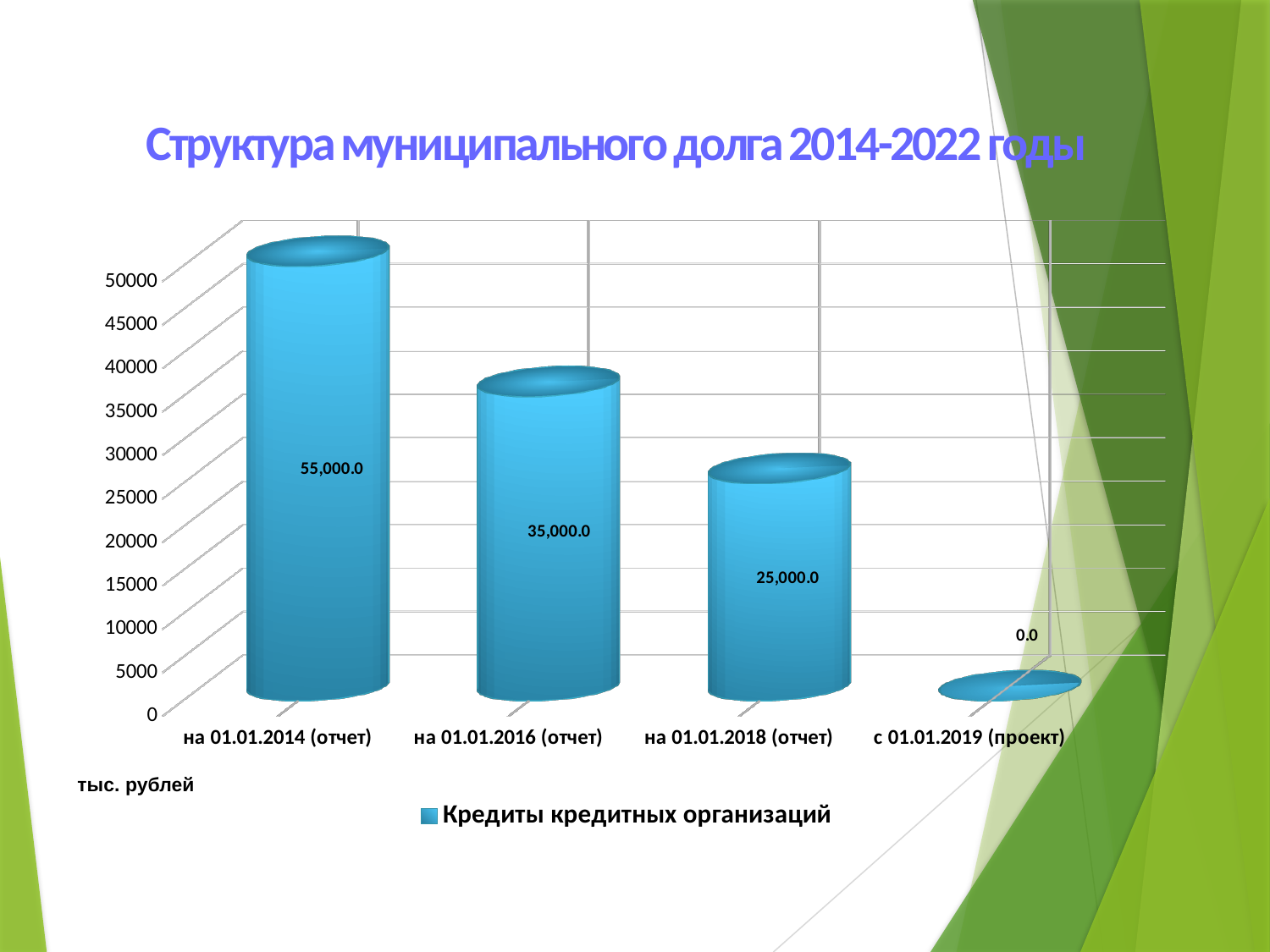
How many series does the legend list? 1 Do the values rise or fall from left to right along the x axis? Fall What is the value for "на 01.01.2014 (отчет)"? 55,000.0 What is the value for "с 01.01.2019 (проект)"? 0.0 What is the difference between the values for "на 01.01.2014 (отчет)" and "на 01.01.2016 (отчет)"? 20,000.0 Which is larger, the value for "на 01.01.2016 (отчет)" or "на 01.01.2018 (отчет)"? на 01.01.2016 (отчет) Which category has the highest value? на 01.01.2014 (отчет) What is the value for "на 01.01.2016 (отчет)"? 35,000.0 How many categories are shown on the x axis? 4 Which category has the lowest value? с 01.01.2019 (проект) What kind of chart is shown on the slide? Bar chart What is the value for "на 01.01.2018 (отчет)"? 25,000.0